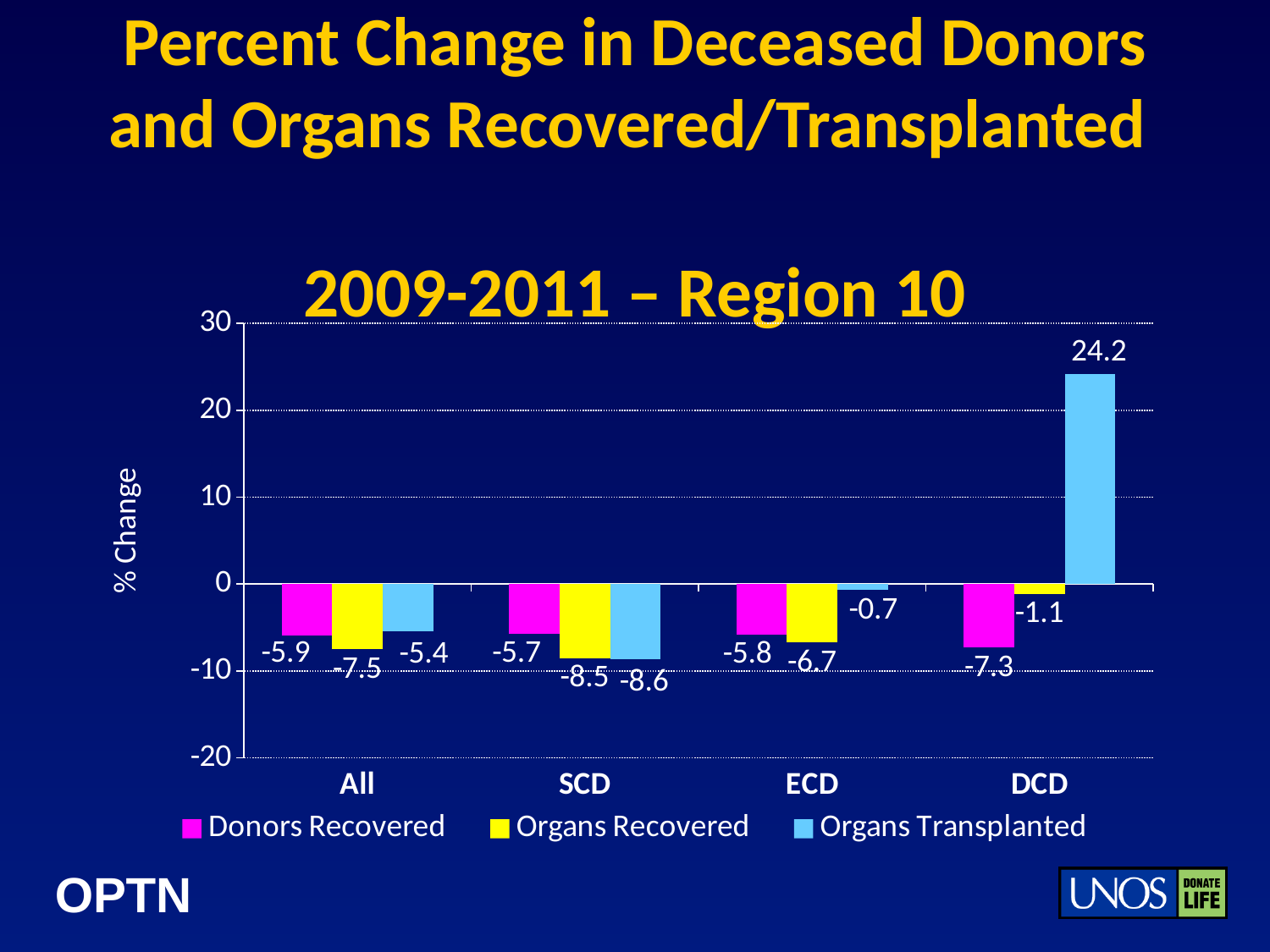
What is the percent change in Donors Recovered for the All category? -5.9 Which is larger: the Organs Recovered value for All or the Organs Recovered value for ECD? ECD What is the percent change in Organs Transplanted for ECD? -0.7 What type of chart is shown on the slide? bar chart What is the difference between the Organs Transplanted value for DCD and the Organs Recovered value for DCD? 25.3 What is the percent change in Organs Recovered for SCD? -8.5 Which category has the highest value for Organs Transplanted? DCD How many categories are shown on the x axis? 4 What is the percent change in Organs Transplanted for DCD? 24.2 How many series does the legend list? 3 Which category has the lowest value for Donors Recovered? DCD Is the Organs Transplanted value for DCD greater or less than 20? greater